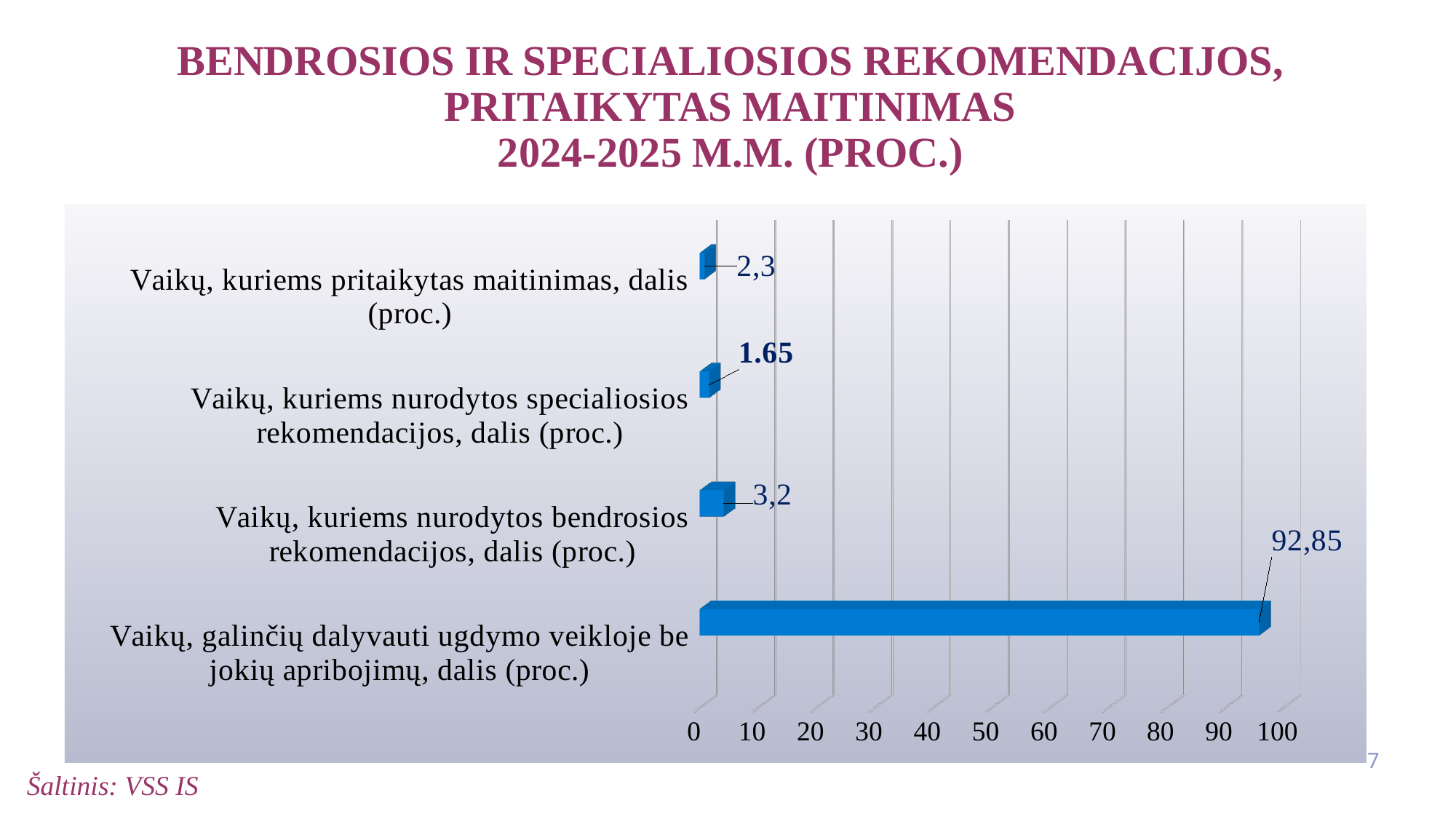
What is the value for "Vaikų, kuriems nurodytos bendrosios rekomendacijos, dalis (proc.)"? 3,2 What is the value for "Vaikų, kuriems pritaikytas maitinimas, dalis (proc.)"? 2,3 What is the value for "Vaikų, galinčių dalyvauti ugdymo veikloje be jokių apribojimų, dalis (proc.)"? 92,85 Which category has the highest value? Vaikų, galinčių dalyvauti ugdymo veikloje be jokių apribojimų, dalis (proc.) Is the value for "Vaikų, galinčių dalyvauti ugdymo veikloje be jokių apribojimų" greater or less than 90? greater What is the value for "Vaikų, kuriems nurodytos specialiosios rekomendacijos, dalis (proc.)"? 1.65 What kind of chart is shown on the slide? bar chart How many categories are shown in the chart? 4 What is the maximum value shown on the horizontal axis? 100 What is the difference between the value for "Vaikų, kuriems nurodytos bendrosios rekomendacijos" and the value for "Vaikų, kuriems pritaikytas maitinimas"? 0,9